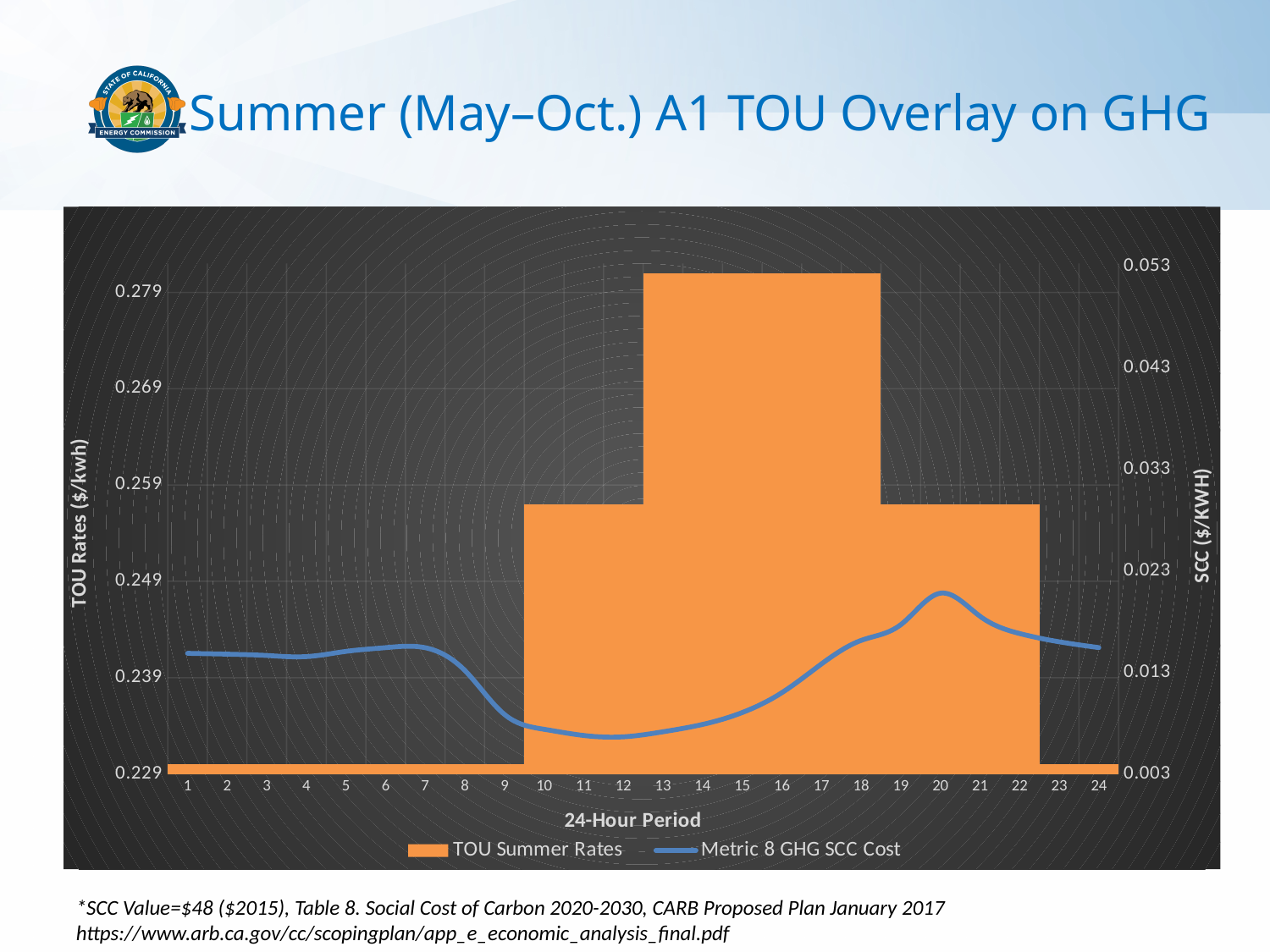
Is the TOU Summer Rates value at hour 10 greater or less than 0.259? less What is the title of the chart? Summer (May–Oct.) A1 TOU Overlay on GHG What kind of chart is shown on the slide? A combined bar and line chart How many series does the legend list? 2 Which is larger, the TOU Summer Rates value at hour 15 or at hour 20? Hour 15 Is the TOU Summer Rates value at hour 15 greater or less than 0.269? greater How many hours are shown along the x axis? 24 Is the TOU Summer Rates value at hour 5 greater or less than 0.239? less Does the Metric 8 GHG SCC Cost line rise or fall between hour 12 and hour 20? Rise Which series is drawn as a line? Metric 8 GHG SCC Cost At which hour does the Metric 8 GHG SCC Cost line reach its highest point? 20